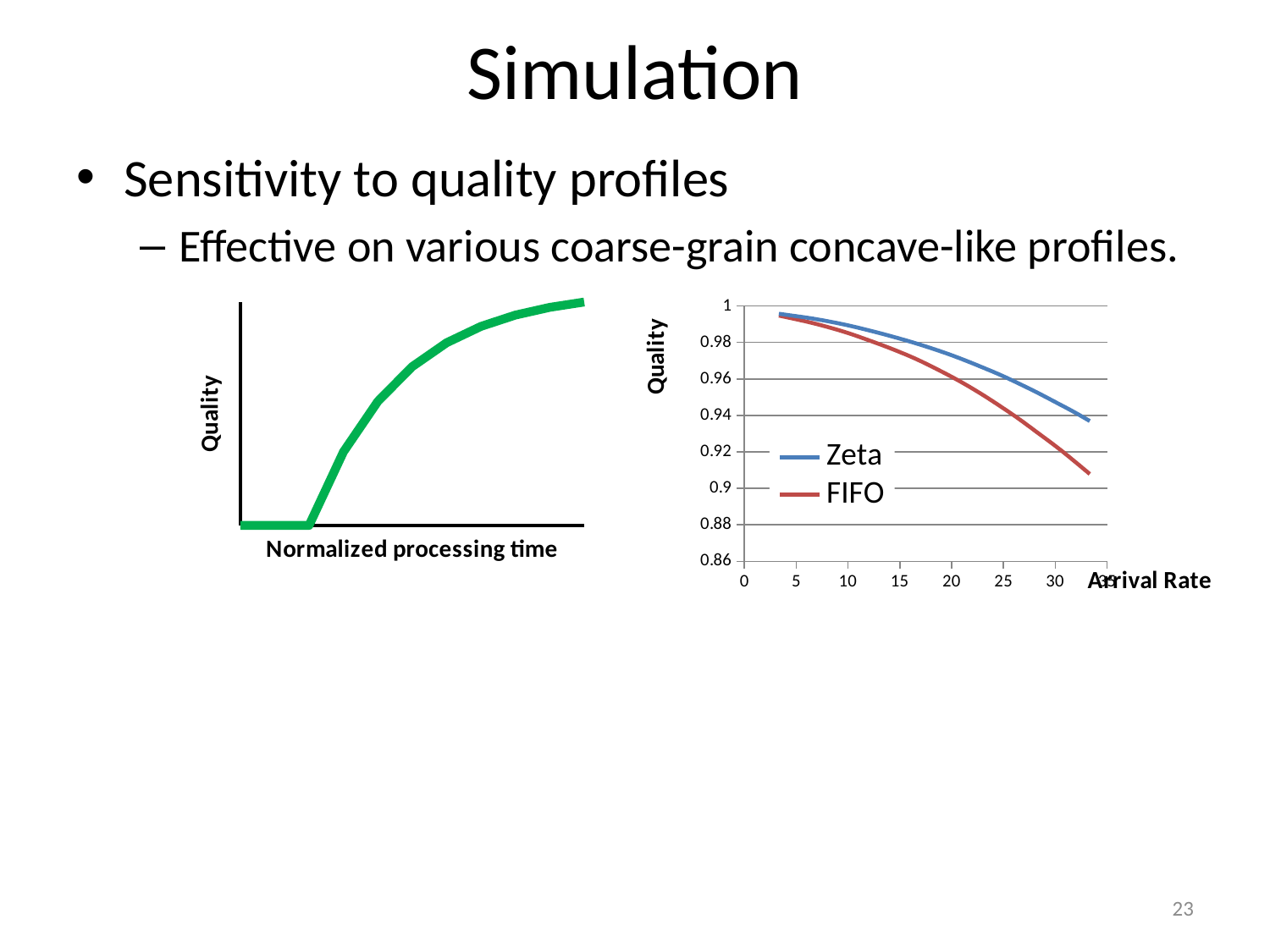
In the right-hand chart, is the quality of the FIFO series at its highest arrival rate greater or less than 0.92? less In the right-hand chart, at an arrival rate of 30, which series has the higher quality, Zeta or FIFO? Zeta In the right-hand chart, does the Zeta series rise or fall as the arrival rate increases? fall In the right-hand chart, is the quality of the FIFO series at an arrival rate of 10 greater or less than 0.96? greater What kind of chart is the right-hand chart with the Zeta and FIFO series? line chart In the right-hand chart, what is the label of the x axis? Arrival Rate In the right-hand chart, how many series does the legend list? 2 In the right-hand chart, what are the names of the two series in the legend? Zeta and FIFO In the right-hand chart, is the quality of the Zeta series at its highest arrival rate greater or less than 0.92? greater In the left-hand chart, does quality rise or fall as normalized processing time increases? rise In the right-hand chart, does the FIFO series rise or fall as the arrival rate increases? fall What kind of chart is the left-hand chart with the green line? line chart